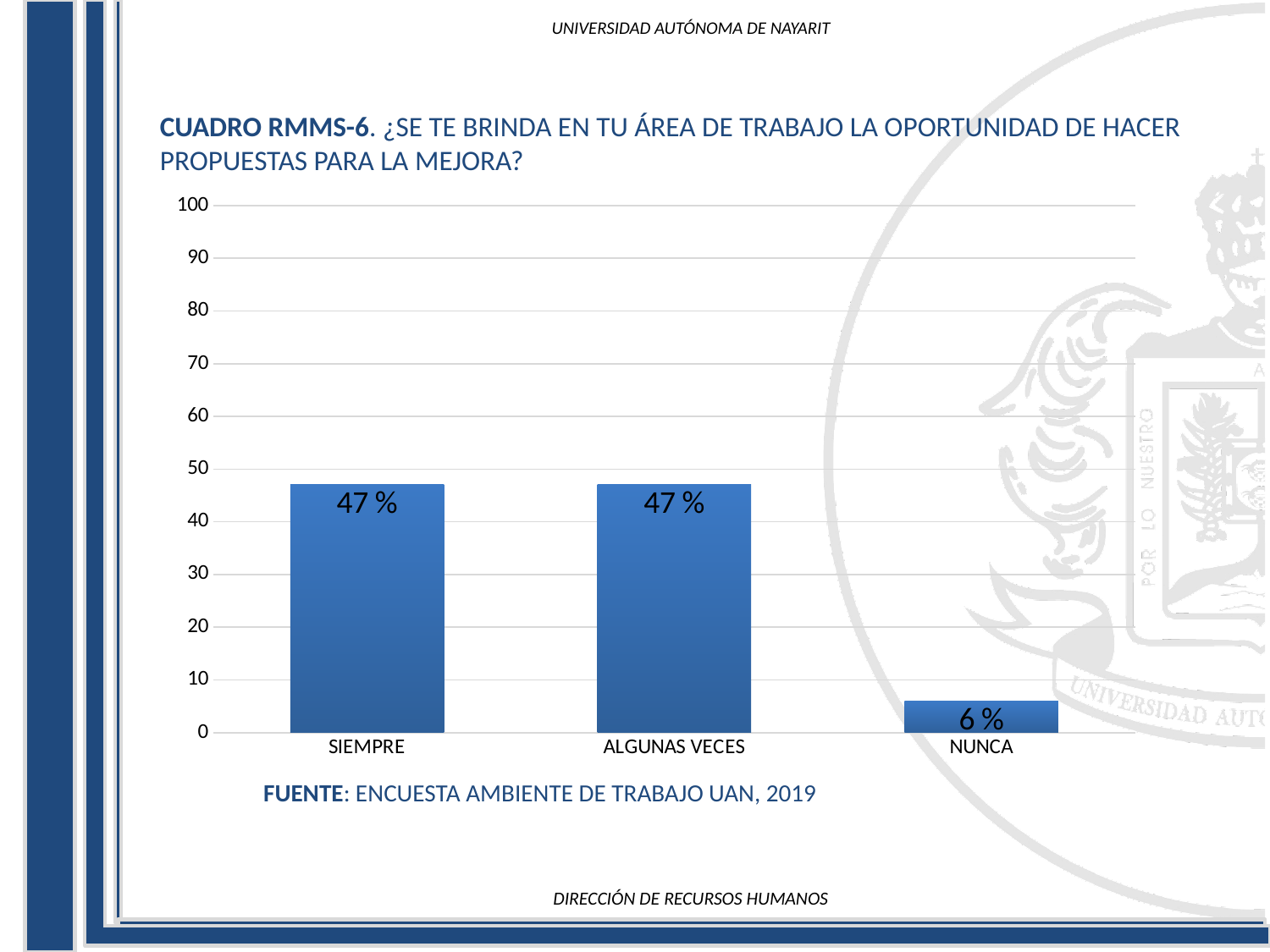
Is the value for SIEMPRE greater or less than 50? less What source is cited below the chart? ENCUESTA AMBIENTE DE TRABAJO UAN, 2019 Which category has the lowest value? NUNCA What kind of chart is shown on the slide? bar chart What is the highest value shown on the y axis? 100 Is the value for NUNCA greater or less than 10? less What is the value for SIEMPRE? 47 % Which is larger, the value for ALGUNAS VECES or the value for NUNCA? ALGUNAS VECES How many categories are shown on the x axis? 3 What is the value for ALGUNAS VECES? 47 % What is the value for NUNCA? 6 % What is the difference between the values for SIEMPRE and NUNCA? 41 %